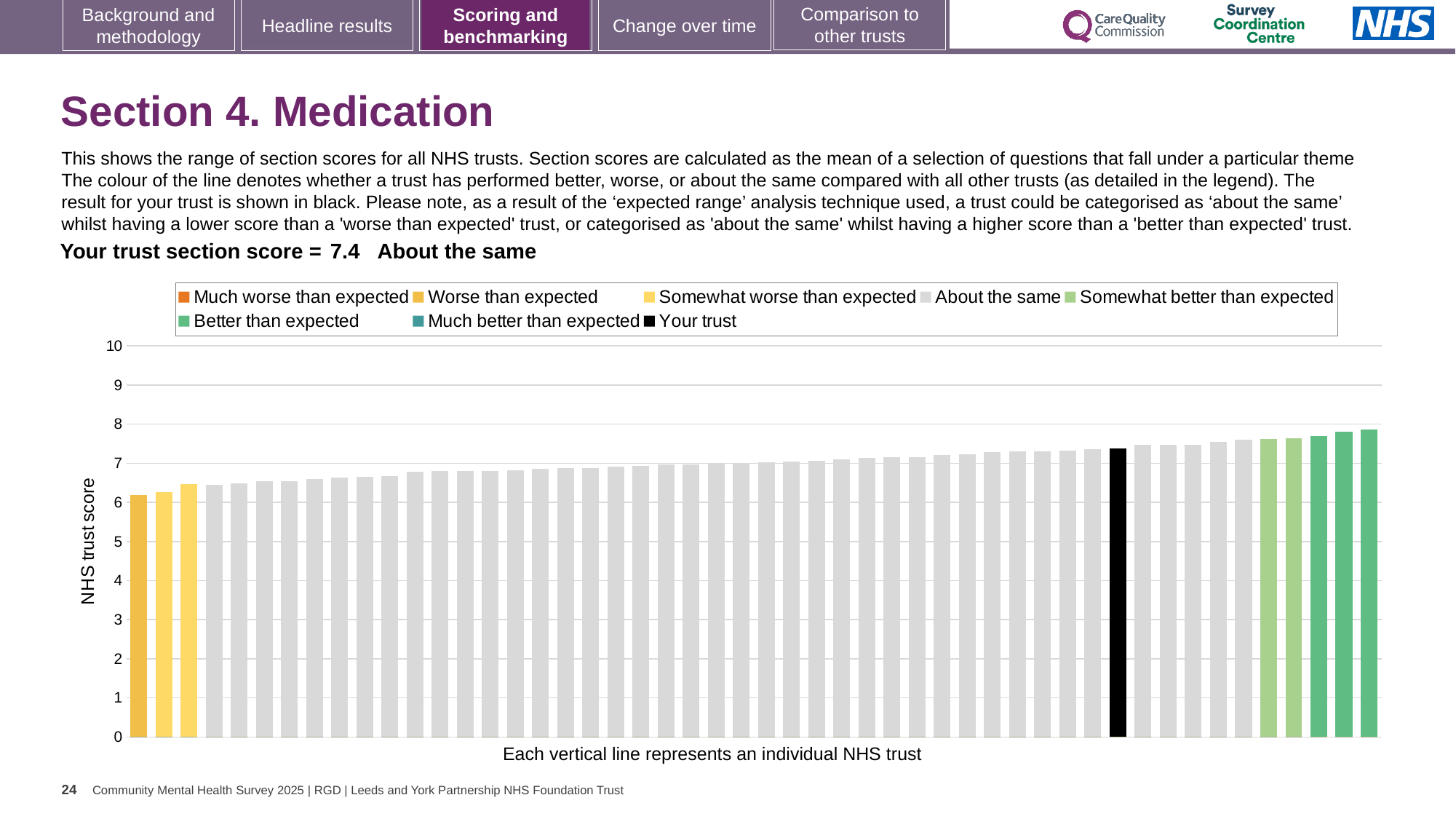
How many bars are coloured in shades of green? 5 Which is larger: the black bar for your trust or the leftmost bar? the black bar for your trust What is the section score for your trust shown on the slide? 7.4 Is the value of the rightmost (highest) bar greater or less than 8? less What kind of chart is shown on the slide? bar chart Is the value for your trust (the black bar) greater or less than 7? greater Do the bar values rise or fall from left to right along the x axis? rise How many entries does the chart legend list? 8 Which is larger: the rightmost bar or the black bar for your trust? the rightmost bar What is the title of the vertical axis? NHS trust score Is the value of the leftmost (lowest) bar greater or less than 7? less What colour is the bar representing your trust? black